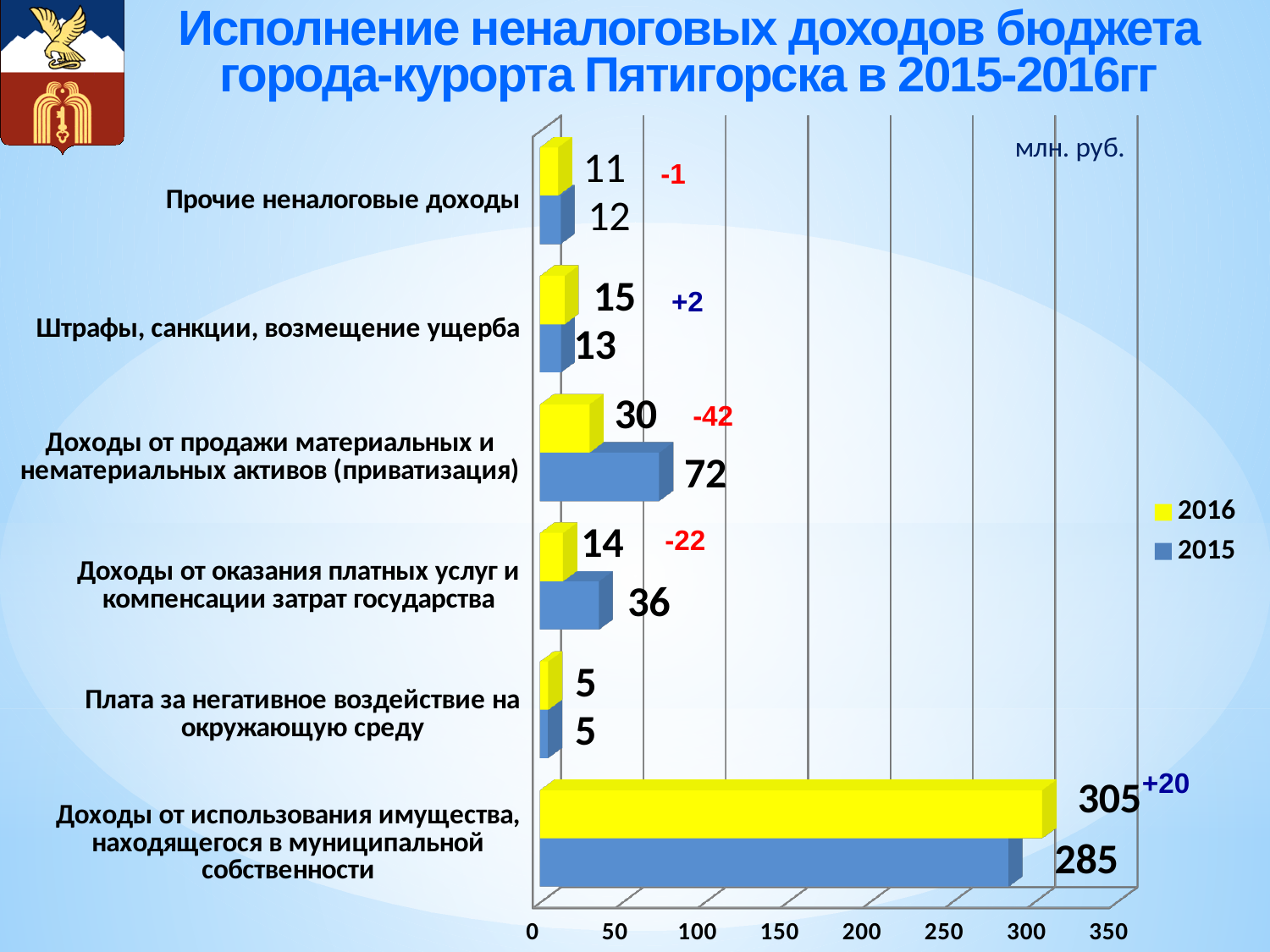
How many categories are shown in the chart? 6 Which is larger for «Прочие неналоговые доходы»: the 2015 value or the 2016 value? 2015 What is the 2015 value for «Доходы от продажи материальных и нематериальных активов (приватизация)»? 72 What is the 2016 value for «Доходы от использования имущества, находящегося в муниципальной собственности»? 305 What is the 2016 value for «Штрафы, санкции, возмещение ущерба»? 15 What unit of measurement is indicated on the chart? млн. руб. Which category has the lowest 2016 value? Плата за негативное воздействие на окружающую среду What is the difference between the 2015 and 2016 values for «Доходы от оказания платных услуг и компенсации затрат государства»? 22 What kind of chart is shown on the slide? bar chart Is the 2015 value for «Доходы от использования имущества, находящегося в муниципальной собственности» greater or less than 250? greater Which category has the highest 2015 value? Доходы от использования имущества, находящегося в муниципальной собственности How many series does the legend list? 2